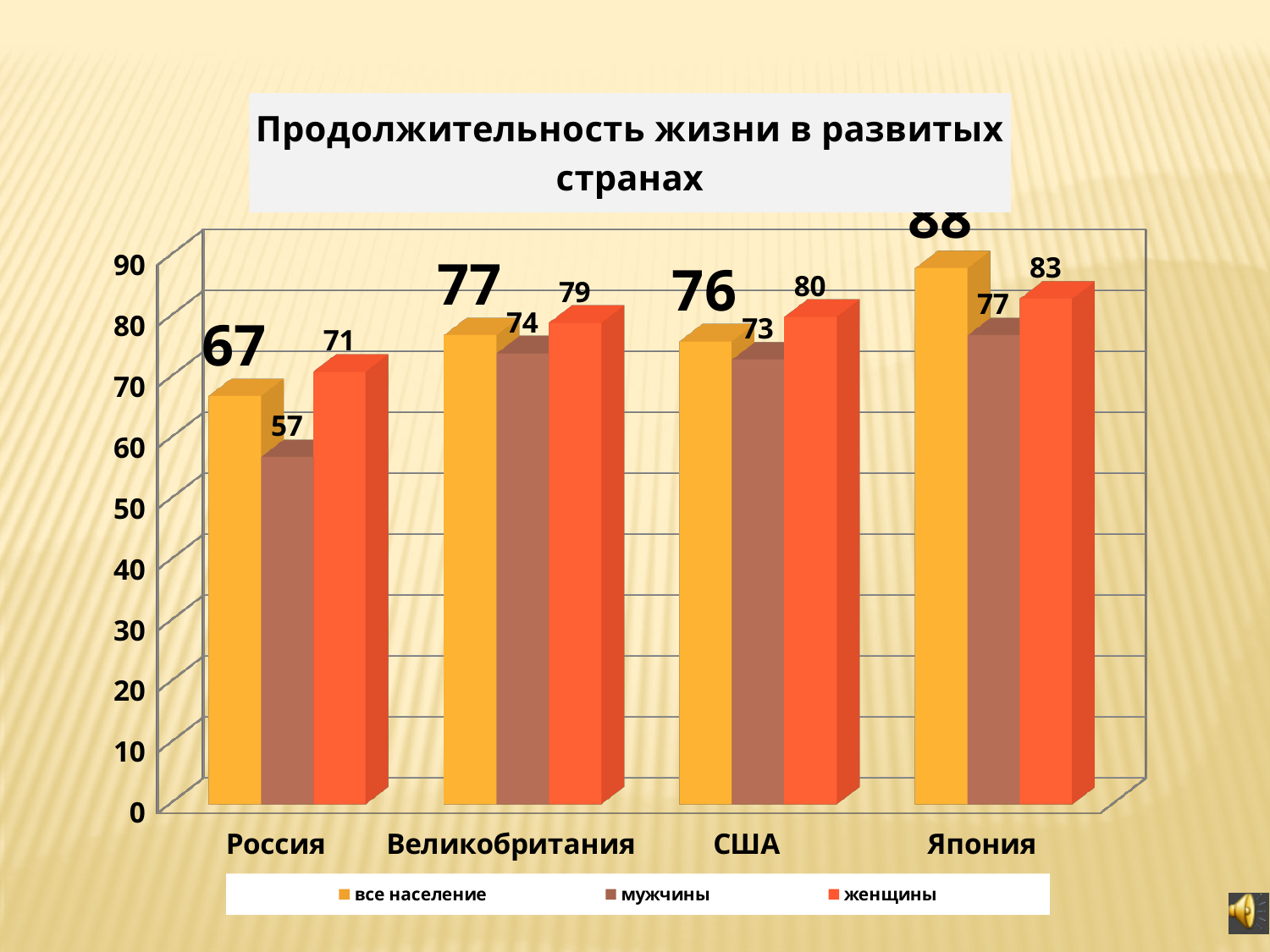
What is the value for все население in Великобритания? 77 What is the value for женщины in США? 80 What is the difference between the женщины and мужчины values in Россия? 14 Which is larger: the женщины value for Великобритания or the женщины value for США? США What is the value for мужчины in Россия? 57 What kind of chart is shown on the slide? bar chart Which country has the lowest value for мужчины? Россия What is the value for мужчины in Япония? 77 Which country has the highest value for все население? Япония How many countries are shown on the x axis? 4 Is the value for все население in Япония greater or less than 80? greater How many series does the legend list? 3